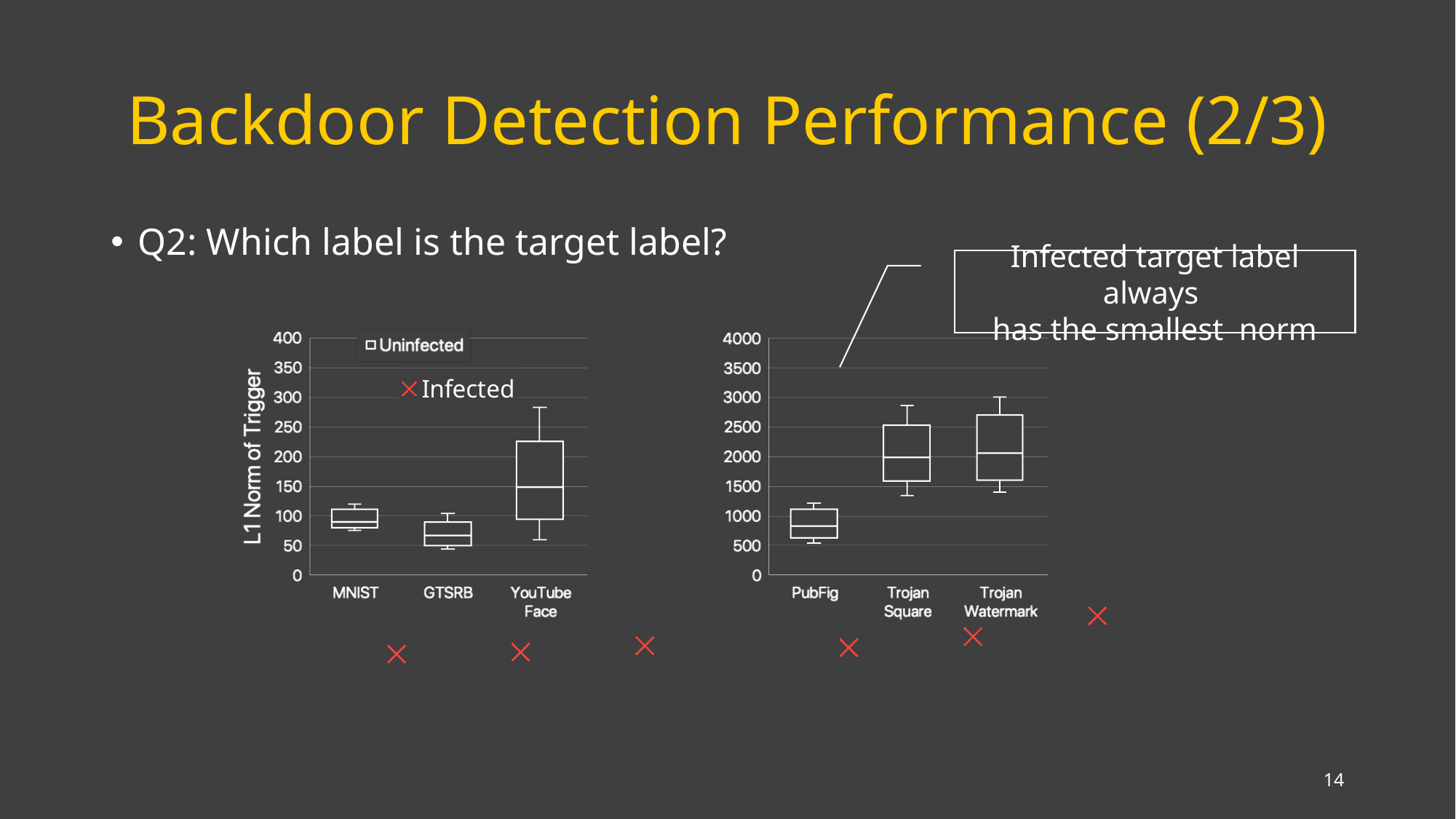
In the right chart, is the median value for Trojan Square greater or less than 1500? greater In the left chart, which category has the highest median L1 norm? YouTube Face How many categories are shown on the x axis of the left chart? 3 In the left chart, is the median value for YouTube Face greater or less than 100? greater In the right chart, which category has the lowest median L1 norm? PubFig In the right chart, is the median value for PubFig greater or less than 1000? less What is the y-axis label of the left chart? L1 Norm of Trigger In the left chart, which category has the lowest median L1 norm? GTSRB What kind of chart is the left chart (MNIST, GTSRB, YouTube Face)? Box plot How many categories are shown on the x axis of the right chart (PubFig, Trojan Square, Trojan Watermark)? 3 In the left chart, which has the larger median L1 norm, MNIST or YouTube Face? YouTube Face